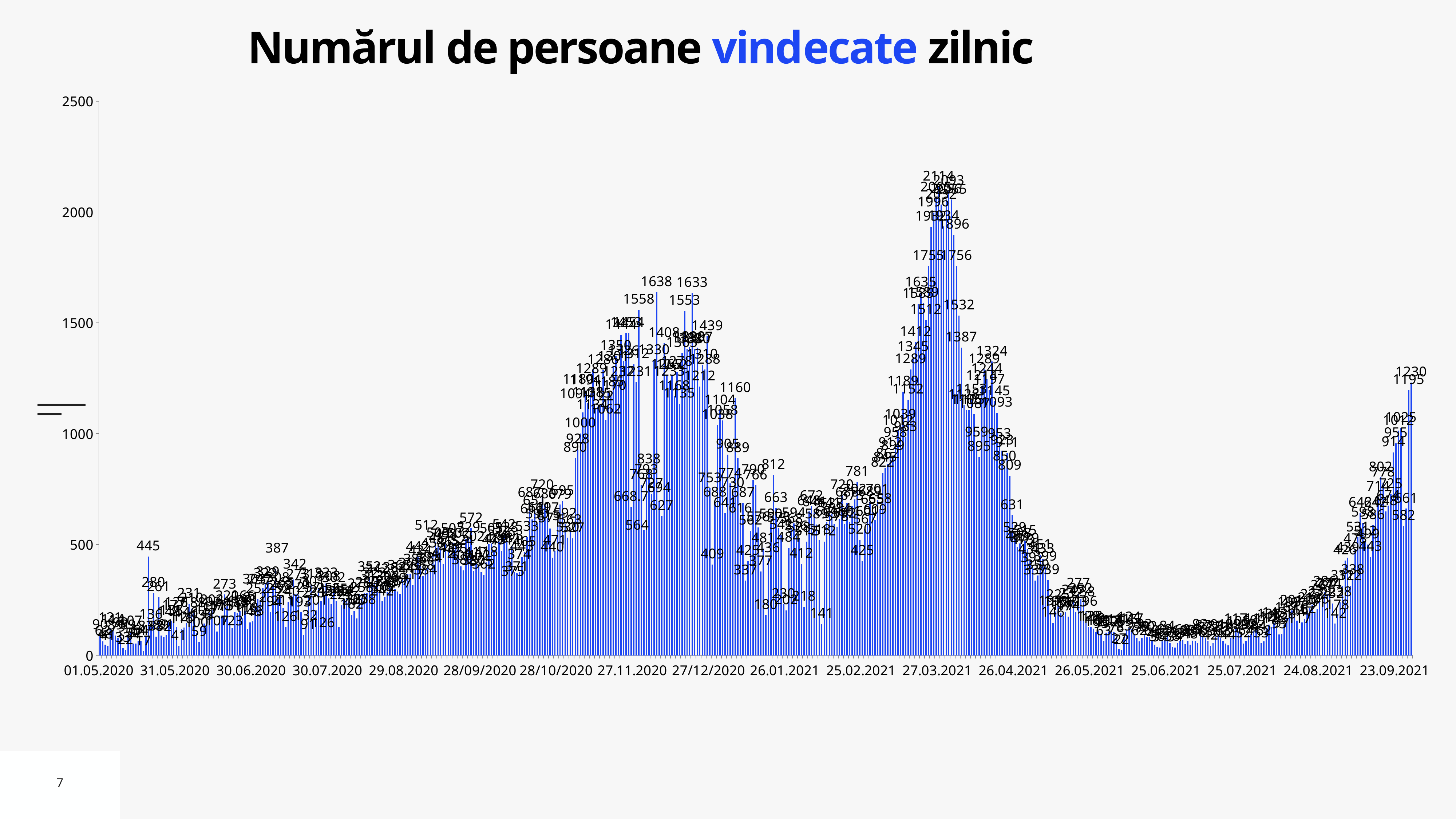
What is the difference between the highest labelled value, 2114, and the last bar's value, 1230? 884 Do the values rise or fall between 24.08.2021 and 23.09.2021? rise What kind of chart is shown on the slide? bar chart Is the peak value around 27.03.2021 greater or less than 2000? greater What is the value labelled on the last bar of the chart, at 23.09.2021? 1230 Is the value of the last bar, at 23.09.2021, greater or less than 1000? greater What is the highest value shown on the vertical axis? 2500 Do the values rise or fall between 26.04.2021 and 26.05.2021? fall Which is larger: the peak around 27.03.2021 or the peak around 27.11.2020? the peak around 27.03.2021 Are the values around 25.06.2021 greater or less than 500? less What is the highest daily value labelled on the chart? 2114 What is the title of the chart? Numărul de persoane vindecate zilnic